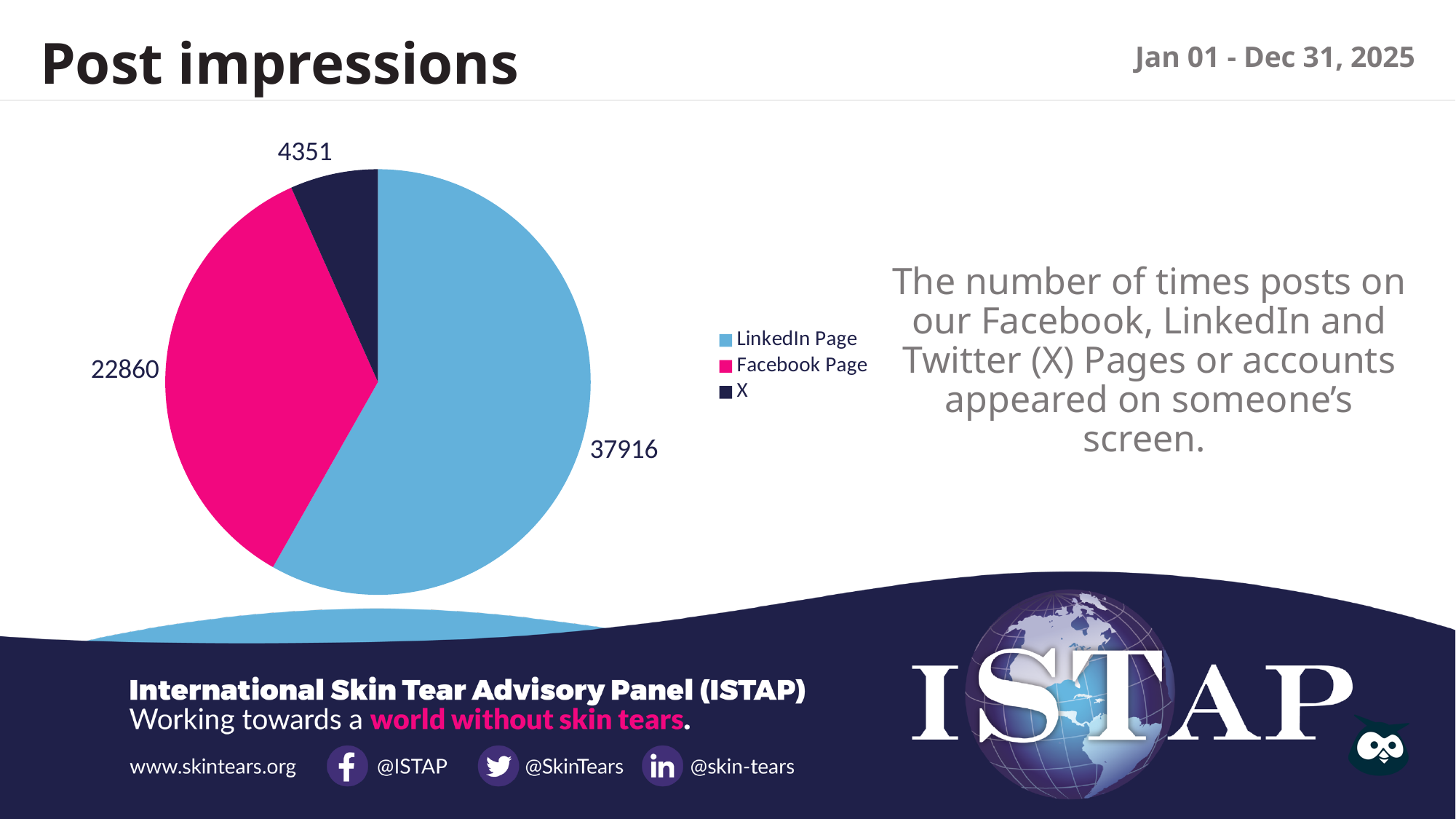
What type of chart is shown on the slide? pie chart What is the value for LinkedIn Page? 37916 Which is larger, the value for Facebook Page or the value for X? Facebook Page Which category has the highest number of post impressions? LinkedIn Page What is the value for X? 4351 Which category has the lowest number of post impressions? X What is the value for Facebook Page? 22860 How many entries does the legend list? 3 What is the title of the slide containing the chart? Post impressions What is the difference between the LinkedIn Page and Facebook Page values? 15056 What is the difference between the Facebook Page and X values? 18509 How many slices does the pie chart have? 3